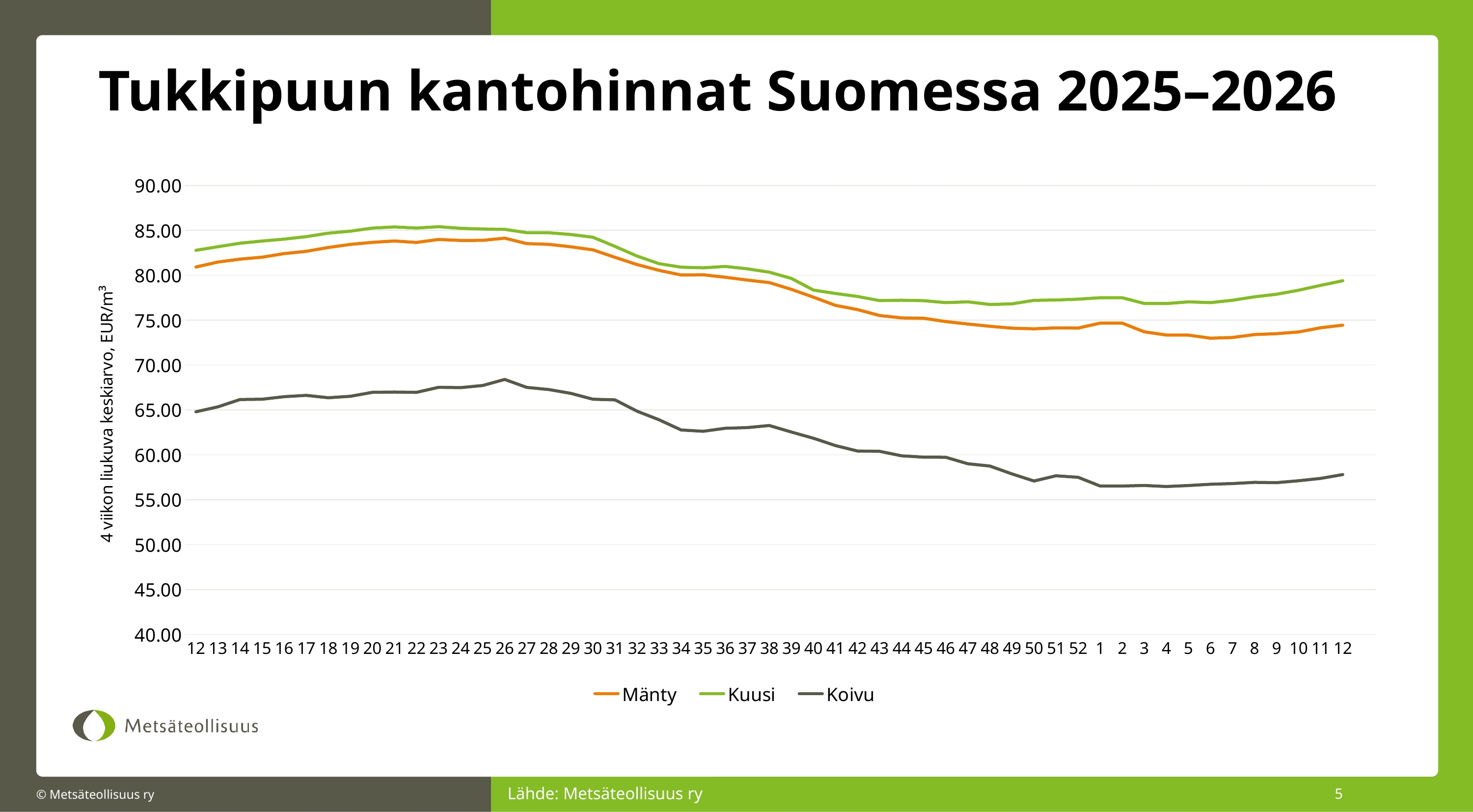
Which series is plotted with the lowest values across the whole chart? Koivu What is the title of the chart? Tukkipuun kantohinnat Suomessa 2025–2026 Is the value for Koivu at week 1 greater or less than 60? less Is the value for Mänty at week 6 greater or less than 75? less Is the value for Kuusi at week 43 greater or less than 80? less How many series does the legend list? 3 At week 40, which is larger, the value for Kuusi or the value for Mänty? Kuusi What is the label on the vertical axis? 4 viikon liukuva keskiarvo, EUR/m³ What kind of chart is shown on the slide? line chart Which series is plotted with the highest values across the whole chart? Kuusi Does the Koivu line rise or fall between week 26 and week 1? fall